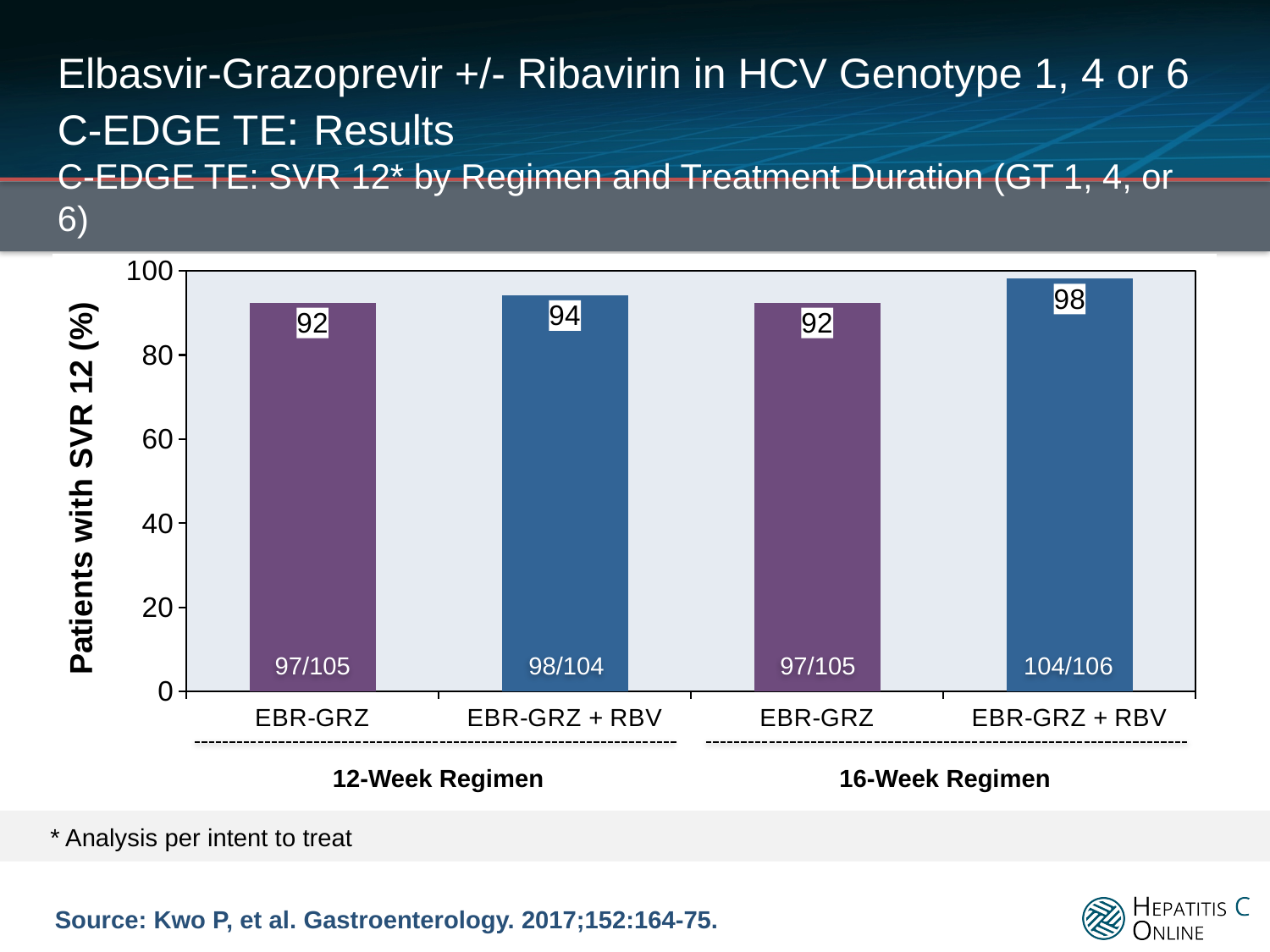
What is the SVR 12 value for EBR-GRZ + RBV in the 16-Week Regimen? 98 What is the difference in SVR 12 between EBR-GRZ + RBV in the 16-Week Regimen and EBR-GRZ + RBV in the 12-Week Regimen? 4 Which is larger: the SVR 12 value for EBR-GRZ + RBV in the 12-Week Regimen or for EBR-GRZ in the 12-Week Regimen? EBR-GRZ + RBV, 12-Week Regimen What fraction of patients is shown inside the EBR-GRZ + RBV bar for the 16-Week Regimen? 104/106 Which bar has the highest SVR 12 value? EBR-GRZ + RBV, 16-Week Regimen What is the label of the y-axis? Patients with SVR 12 (%) What fraction of patients is shown inside the EBR-GRZ + RBV bar for the 12-Week Regimen? 98/104 What is the SVR 12 value for EBR-GRZ in the 12-Week Regimen? 92 How many bars are plotted in the chart? 4 Is the SVR 12 value for EBR-GRZ in the 16-Week Regimen greater or less than 80? greater What is the SVR 12 value for EBR-GRZ + RBV in the 12-Week Regimen? 94 What kind of chart is shown on the slide? Bar chart